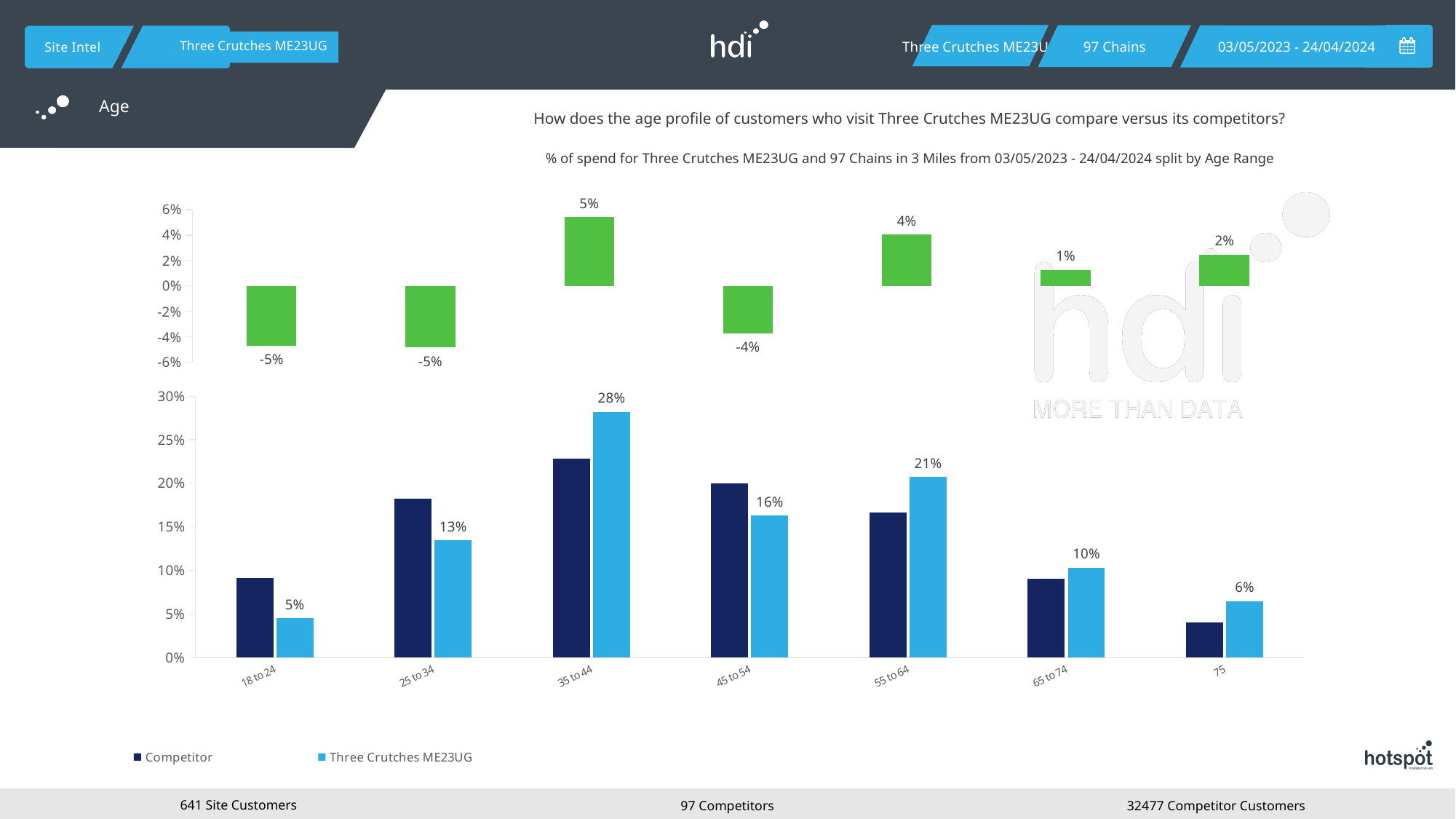
In the bottom chart, which age range has the highest value for Three Crutches ME23UG? 35 to 44 In the bottom chart, for the 25 to 34 age range, which series has the larger value: Competitor or Three Crutches ME23UG? Competitor How many series does the legend of the bottom chart list? 2 In the bottom chart, what is the value for Three Crutches ME23UG in the 35 to 44 age range? 28% How many age range categories are shown on the x axis of the bottom chart? 7 In the top chart, what is the value for the 45 to 54 age range? -4% In the bottom chart, what is the value for Three Crutches ME23UG in the 18 to 24 age range? 5% In the bottom chart, what is the difference between the Three Crutches ME23UG values for 55 to 64 and 65 to 74? 11% In the bottom chart, is the Competitor value for 75 greater or less than 5%? less In the top chart, which age range has the highest value? 35 to 44 In the bottom chart, which age range has the lowest value for Three Crutches ME23UG? 18 to 24 In the bottom chart, is the Competitor value for 35 to 44 greater or less than 20%? greater